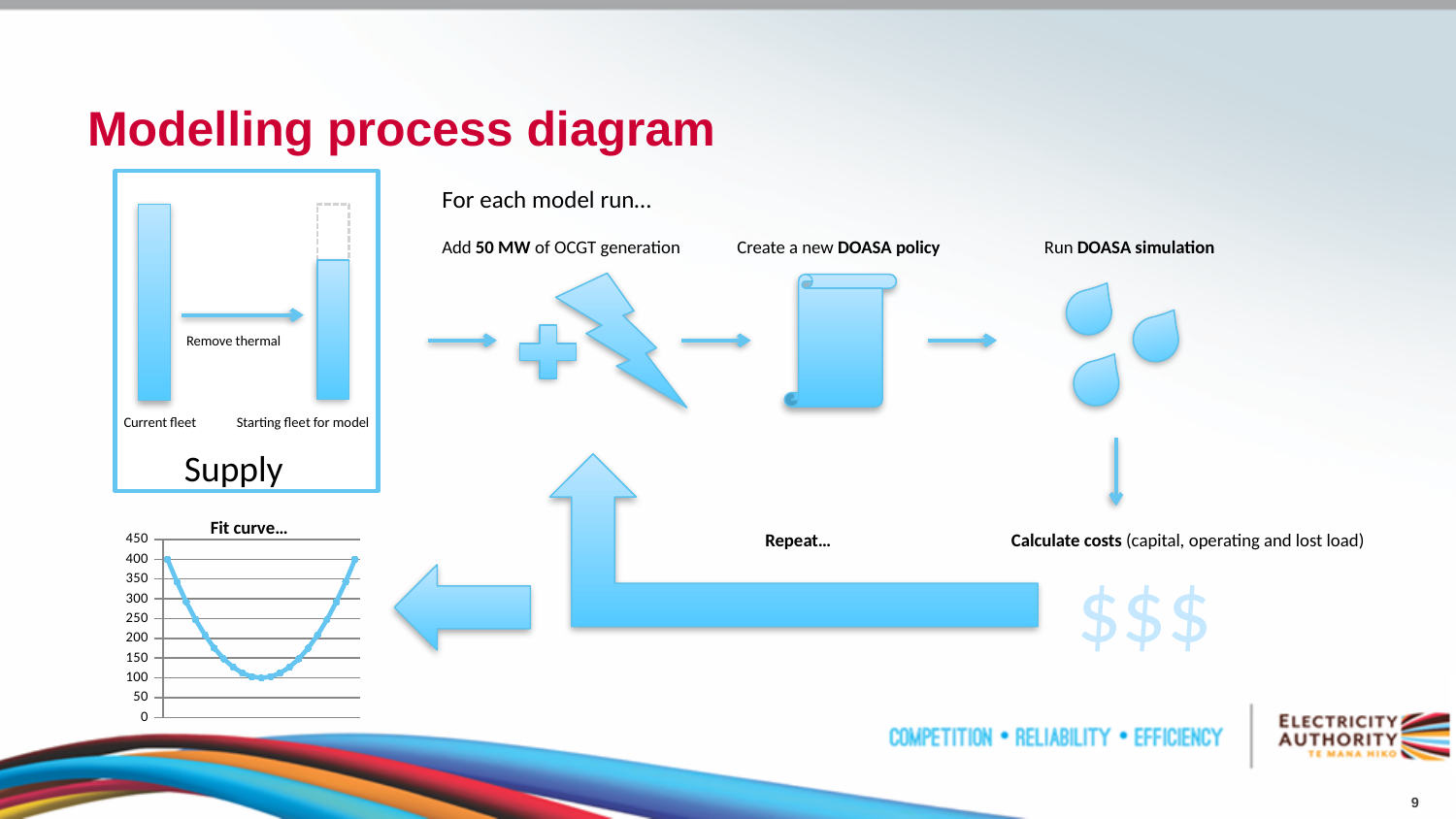
What is the title of the chart in the lower left of the slide? Fit curve… What kind of chart is the "Fit curve…" chart? line chart In the "Fit curve…" chart, is the last point of the curve greater or less than 300? greater In the "Fit curve…" chart, is the lowest point of the curve greater or less than 150? less In the "Fit curve…" chart, do the values rise or fall along the first half of the x axis? fall What is the highest value labelled on the vertical axis of the "Fit curve…" chart? 450 In the "Fit curve…" chart, is the curve's lowest point near the middle or at the ends of the x axis? near the middle In the "Fit curve…" chart, do the values rise or fall along the second half of the x axis? rise In the "Fit curve…" chart, is the lowest point of the curve greater or less than 50? greater